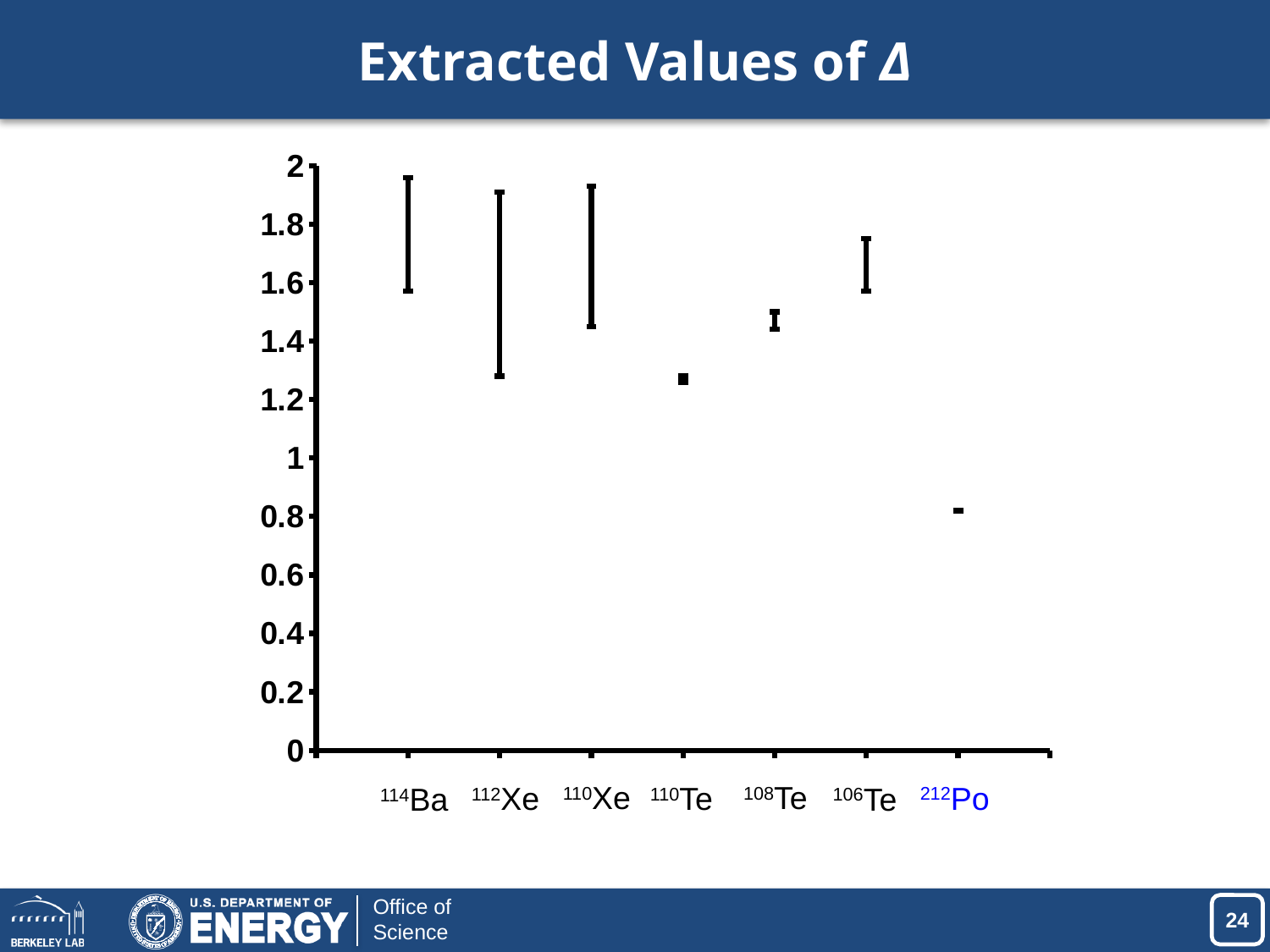
Which x-axis label on the chart is written in blue rather than black? 212Po Is the value for 110Te greater or less than 1.2? greater What is the highest tick value shown on the y axis of the chart? 2 Which isotope has the lowest extracted value of Δ in the chart? 212Po What is the title of the slide containing the chart? Extracted Values of Δ Is the value for 108Te greater or less than 1.4? greater Which has the larger value of Δ, 114Ba or 212Po? 114Ba Is the value for 106Te greater or less than 1.4? greater Which has the larger value of Δ, 110Te or 212Po? 110Te How many isotopes are plotted along the x axis of the chart? 7